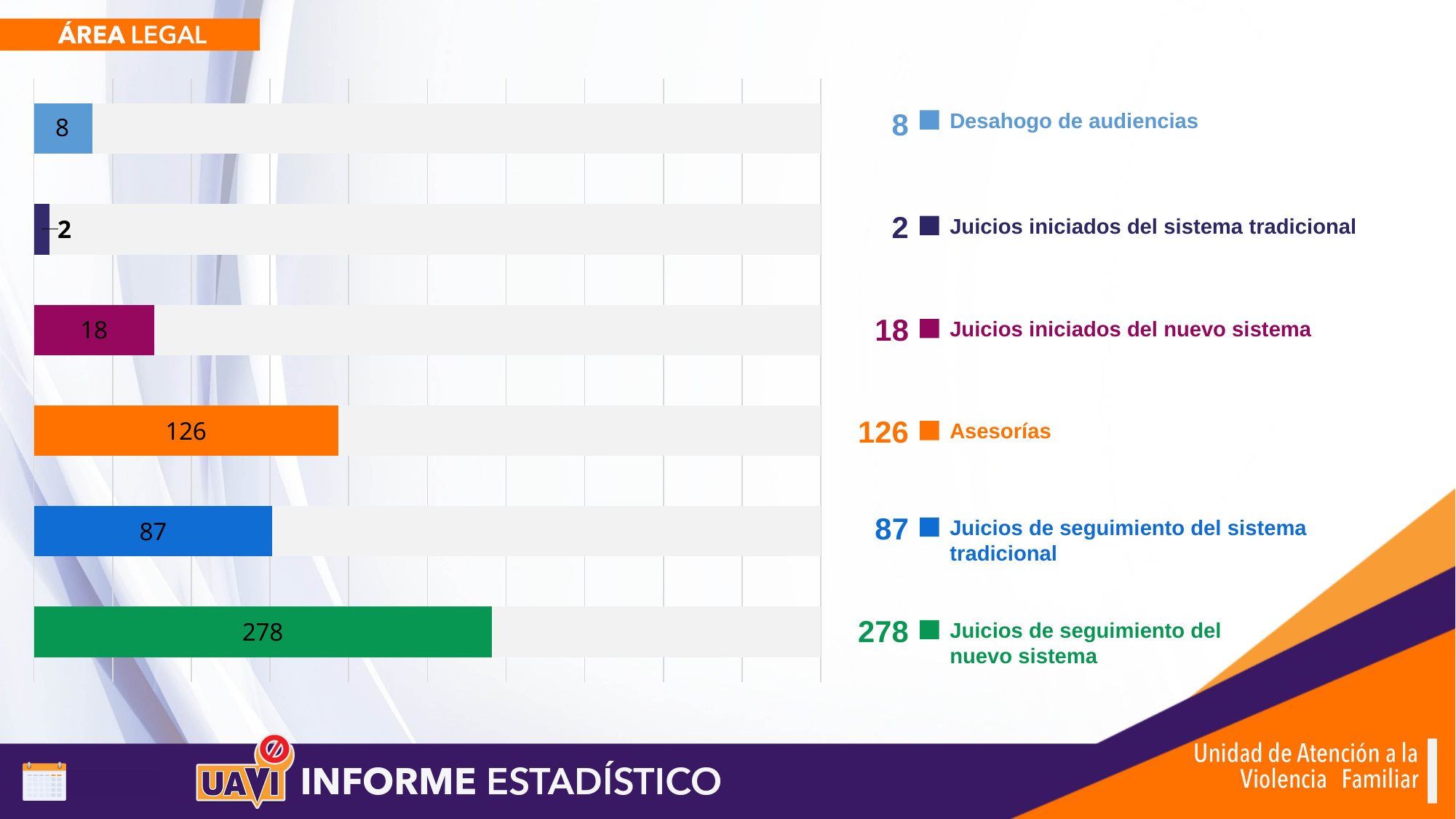
How many categories are shown in the chart? 6 What is the value for Desahogo de audiencias? 8 What is the difference between Asesorías and Juicios iniciados del nuevo sistema? 108 What kind of chart is shown on the slide? Bar chart Which is larger, Asesorías or Juicios de seguimiento del sistema tradicional? Asesorías Which category has the lowest value? Juicios iniciados del sistema tradicional What is the value for Juicios iniciados del nuevo sistema? 18 What is the value for Asesorías? 126 What is the difference between Juicios de seguimiento del nuevo sistema and Juicios de seguimiento del sistema tradicional? 191 What is the value for Juicios de seguimiento del sistema tradicional? 87 What colour is the bar for Juicios de seguimiento del nuevo sistema? Green Which category has the highest value? Juicios de seguimiento del nuevo sistema